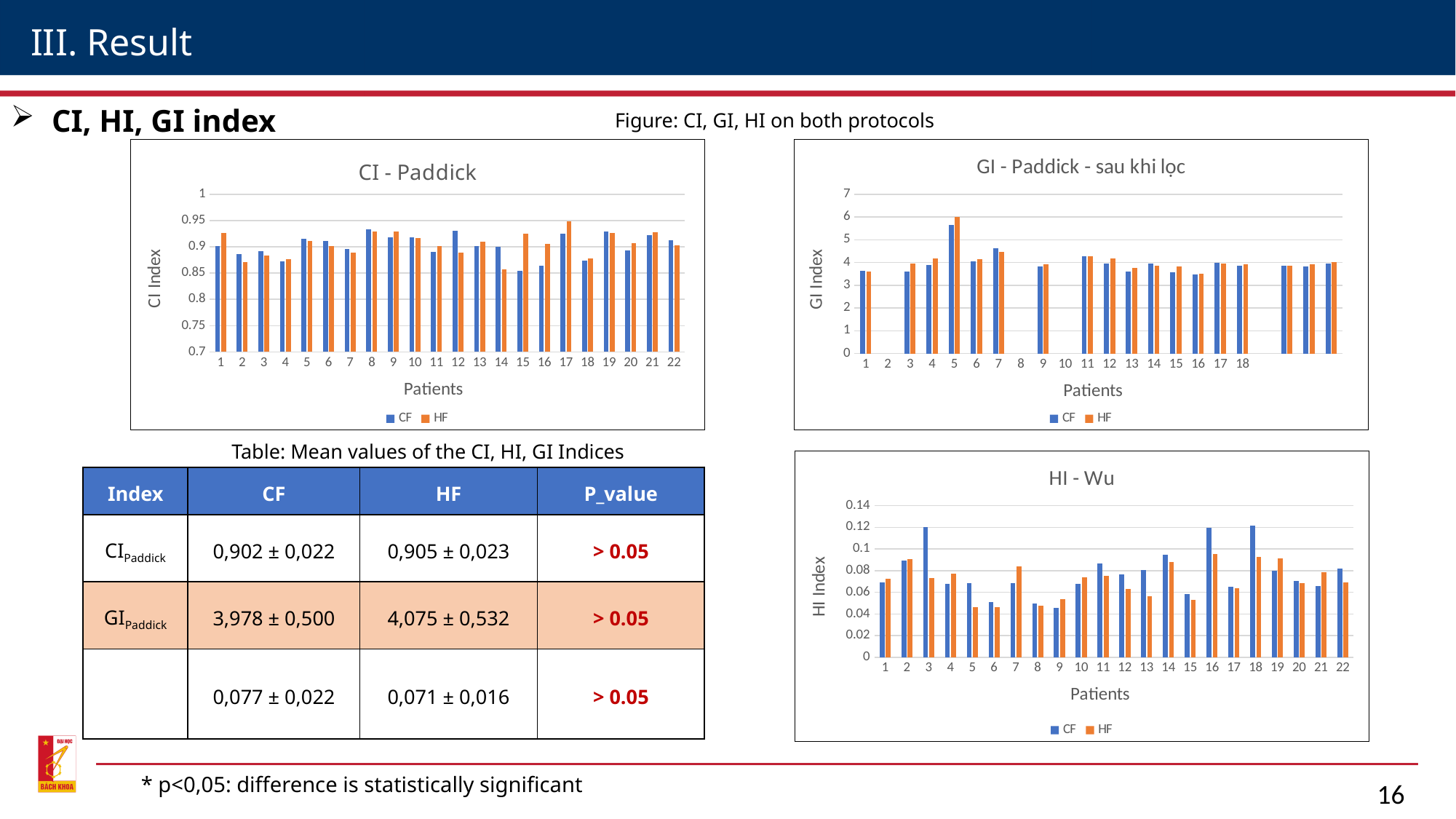
How many patients are shown on the x axis of the 'CI - Paddick' chart? 22 In the 'CI - Paddick' chart, which is larger for patient 14, CF or HF? CF In the 'CI - Paddick' chart, is the HF value for patient 14 greater or less than 0.9? less In the 'GI - Paddick - sau khi lọc' chart, which patient has the highest HF value? 5 What are the two series named in the legend of the 'GI - Paddick - sau khi lọc' chart? CF and HF In the 'HI - Wu' chart, which is larger for patient 7, CF or HF? HF In the 'GI - Paddick - sau khi lọc' chart, is the HF value for patient 5 greater or less than 5? greater What type of chart is the 'CI - Paddick' chart? bar chart What is the x-axis title of the 'HI - Wu' chart? Patients In the 'CI - Paddick' chart, which patient has the highest HF value? 17 How many series does the legend of the 'HI - Wu' chart list? 2 In the 'HI - Wu' chart, is the CF value for patient 3 greater or less than 0.1? greater